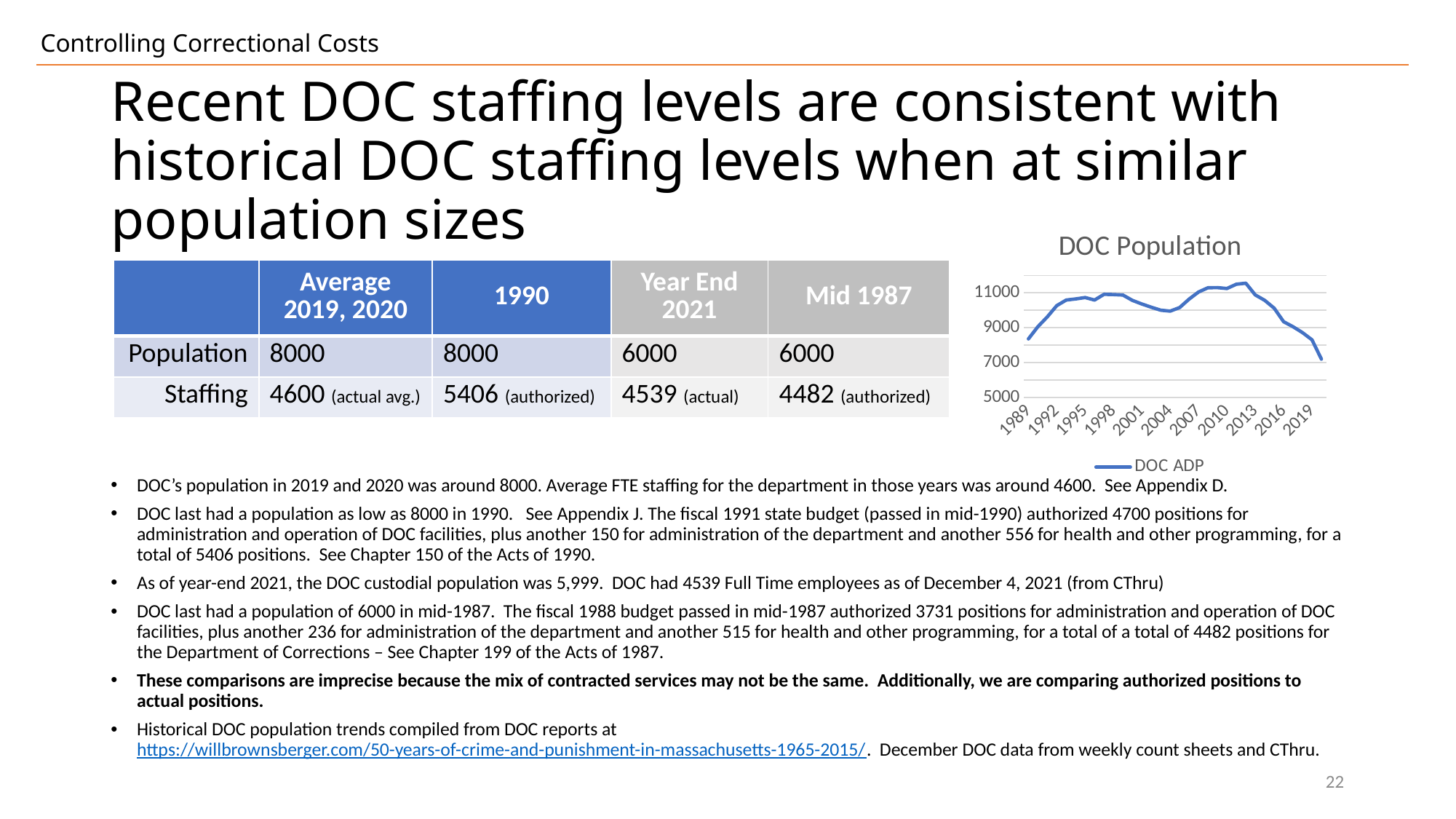
In the DOC Population chart, is the value for 1995 greater or less than 9000? greater What is the name of the series shown in the legend of the DOC Population chart? DOC ADP In the DOC Population chart, is the value for 1989 greater or less than 7000? greater In the DOC Population chart, does the DOC ADP line rise or fall between 2013 and 2019? fall What kind of chart is the DOC Population chart? line chart How many year labels are shown on the x axis of the DOC Population chart? 11 In the DOC Population chart, is the value for 2004 greater or less than 9000? greater What is the title of the chart on the right side of the slide? DOC Population How many series does the legend of the DOC Population chart list? 1